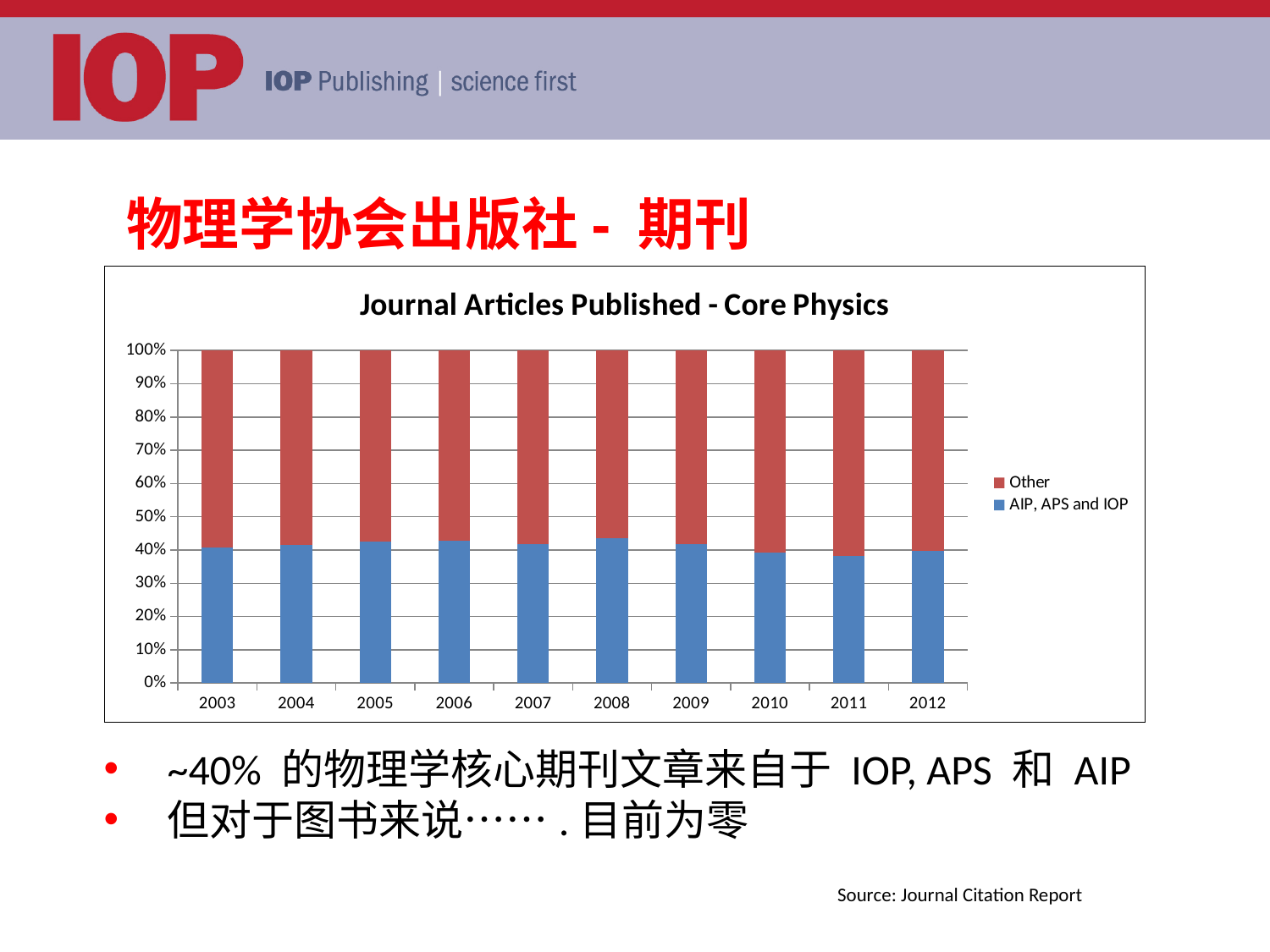
Is the value for Other in 2011 greater or less than 60%? greater How many years are shown on the x axis of the chart? 10 How many series does the chart legend list? 2 What is the total height of each stacked bar in the chart? 100% Is the value for AIP, APS and IOP in 2011 greater or less than 40%? less Is the value for Other in 2008 greater or less than 60%? less What kind of chart is shown on the slide? Stacked bar chart Which is larger, the AIP, APS and IOP share in 2008 or in 2011? 2008 What is the title of the chart? Journal Articles Published - Core Physics Which two series are listed in the chart legend? Other; AIP, APS and IOP Which is larger, the Other share in 2005 or in 2011? 2011